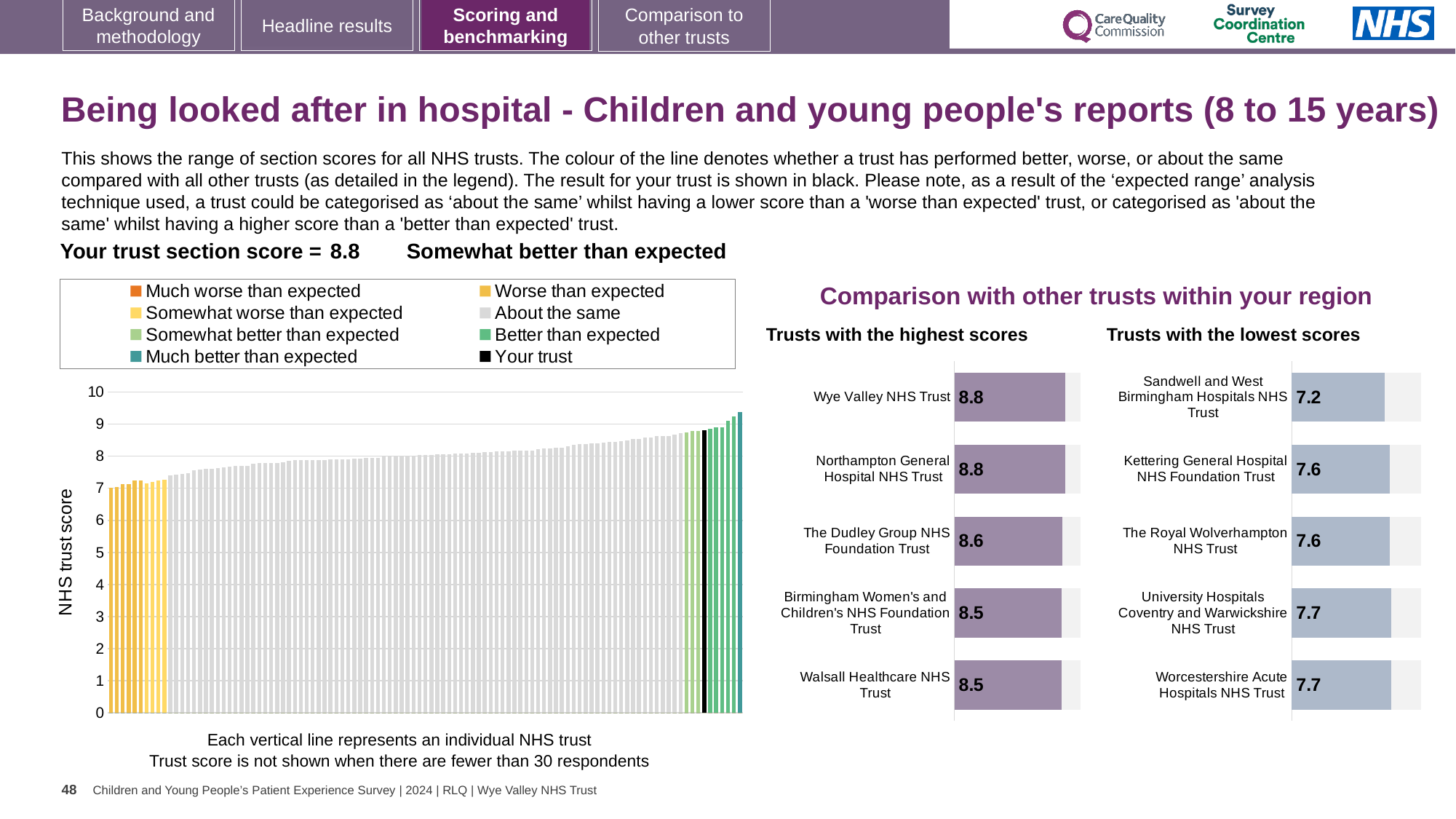
What is the y-axis label of the large chart on the left? NHS trust score How many categories does the legend above the large chart on the left list? 8 In the large chart on the left, do the trust scores rise or fall from left to right? Rise In the large chart on the left, is the value of the leftmost (lowest) bar greater or less than 8? less In the 'Trusts with the highest scores' chart, which has the larger score: The Dudley Group NHS Foundation Trust or Walsall Healthcare NHS Trust? The Dudley Group NHS Foundation Trust What kind of chart is the large chart on the left showing NHS trust scores? Bar chart In the 'Trusts with the highest scores' chart, what is the score for The Dudley Group NHS Foundation Trust? 8.6 In the 'Trusts with the highest scores' chart, how many trusts are listed? 5 In the 'Trusts with the lowest scores' chart, what is the score for Worcestershire Acute Hospitals NHS Trust? 7.7 In the 'Trusts with the lowest scores' chart, which trust has the lowest score? Sandwell and West Birmingham Hospitals NHS Trust What is the difference between Wye Valley NHS Trust's score in the 'Trusts with the highest scores' chart and Sandwell and West Birmingham Hospitals NHS Trust's score in the 'Trusts with the lowest scores' chart? 1.6 In the 'Trusts with the lowest scores' chart, what is the score for Kettering General Hospital NHS Foundation Trust? 7.6